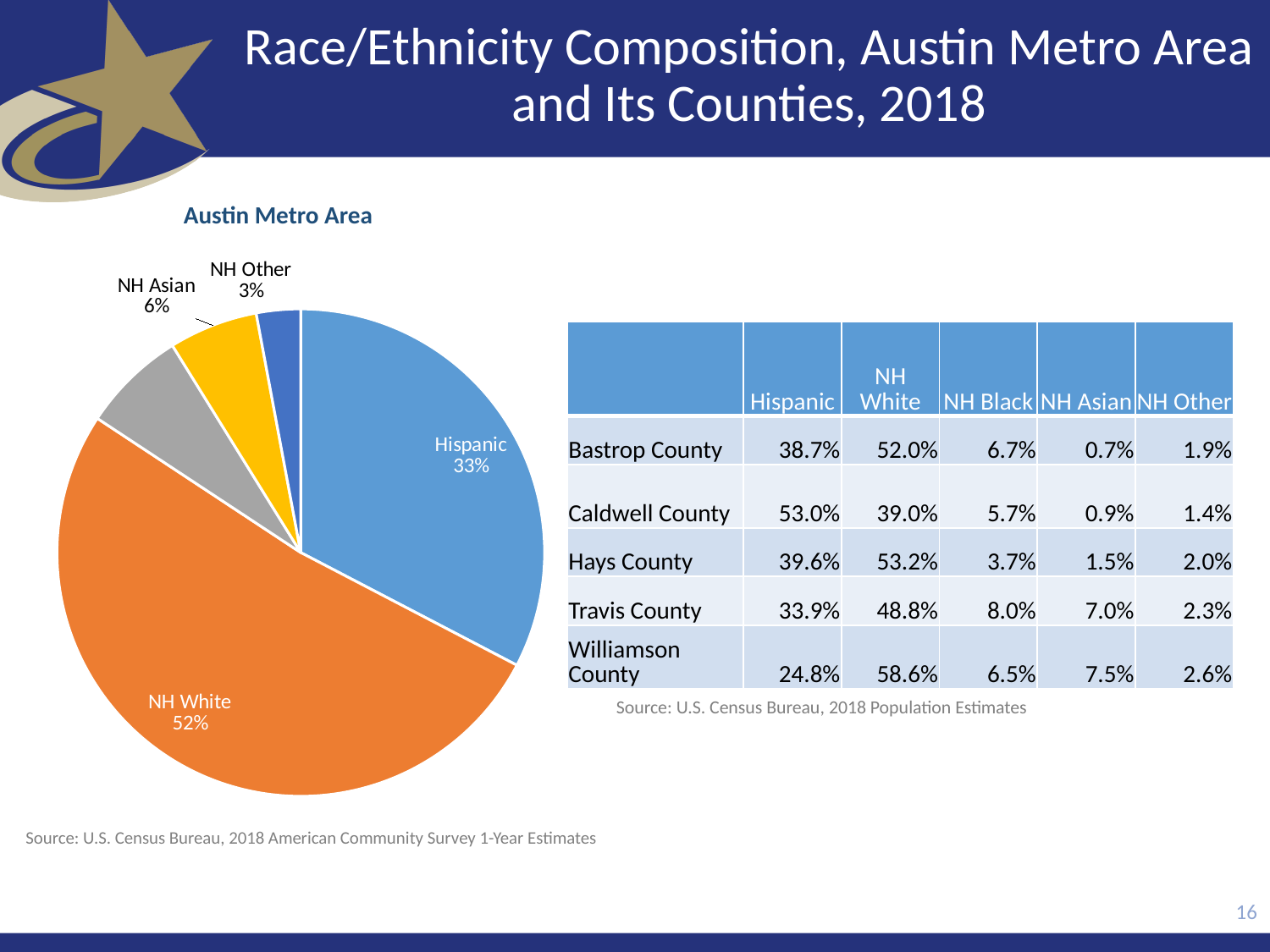
What type of chart is used to show the Austin Metro Area race/ethnicity composition? Pie chart What colour is the NH White slice in the Austin Metro Area pie chart? Orange Which labelled group has the smallest slice in the Austin Metro Area pie chart? NH Other How many slices does the Austin Metro Area pie chart have? 5 Which group has the largest slice in the Austin Metro Area pie chart? NH White In the Austin Metro Area pie chart, how many percentage points larger is the NH Asian share than the NH Other share? 3 percentage points In the Austin Metro Area pie chart, what share of the population is Hispanic? 33% In the Austin Metro Area pie chart, what share of the population is NH White? 52% In the Austin Metro Area pie chart, what percentage is shown for NH Asian? 6% In the Austin Metro Area pie chart, which is larger: the Hispanic slice or the NH White slice? NH White In the Austin Metro Area pie chart, how many percentage points larger is the NH White share than the Hispanic share? 19 percentage points In the Austin Metro Area pie chart, what percentage is shown for NH Other? 3%